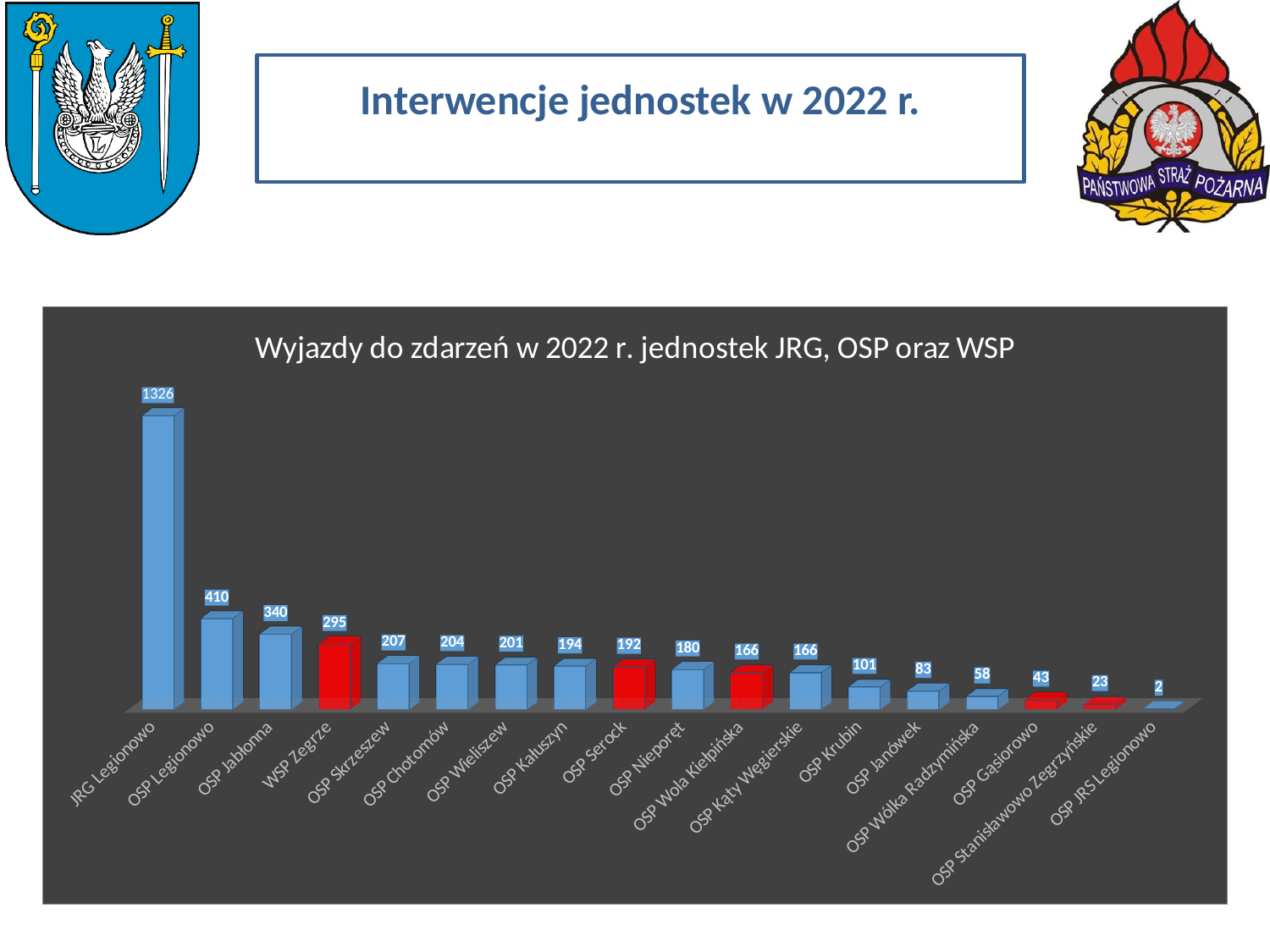
How many units are shown in the chart? 18 What is the value for OSP Jabłonna? 340 What is the title of the chart? Wyjazdy do zdarzeń w 2022 r. jednostek JRG, OSP oraz WSP What is the difference between the values for OSP Legionowo and OSP Jabłonna? 70 What kind of chart is this? Bar chart Which unit has the highest number of interventions? JRG Legionowo Which is larger, the value for OSP Skrzeszew or OSP Nieporęt? OSP Skrzeszew What is the difference between the values for JRG Legionowo and OSP Legionowo? 916 Which unit has the lowest number of interventions? OSP JRS Legionowo What is the value for JRG Legionowo? 1326 What is the value for OSP Krubin? 101 What is the value for WSP Zegrze? 295